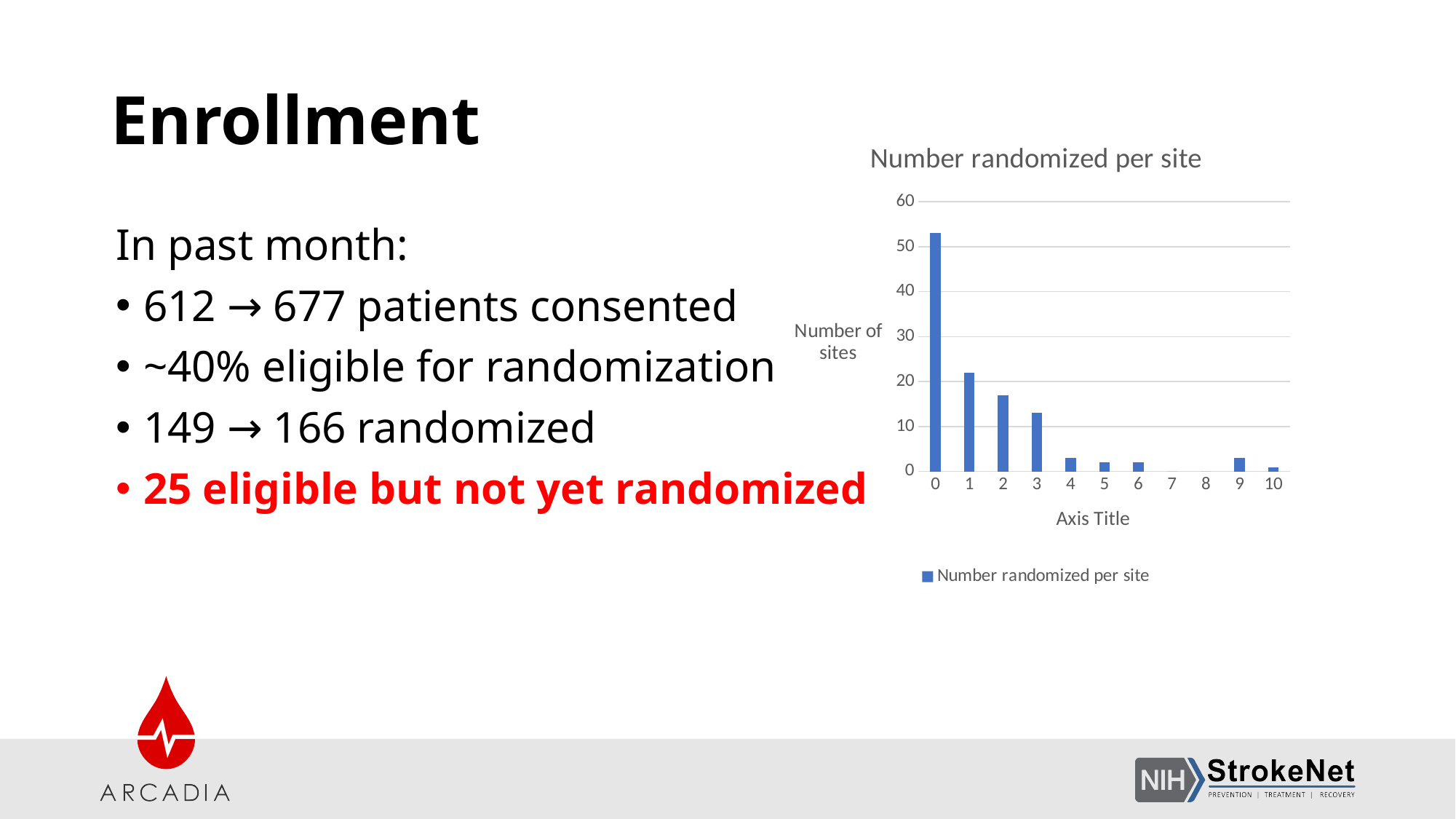
Is the number of sites for category 0 greater or less than 40? greater Is the number of sites for category 2 greater or less than 10? greater How many series does the legend list? 1 Which category has the highest number of sites? 0 What is the label on the vertical axis of the chart? Number of sites What is the title of the chart? Number randomized per site Do the bar heights generally rise or fall as the x axis goes from 0 to 10? fall What kind of chart is shown on the slide? bar chart Is the number of sites for category 1 greater or less than 30? less How many categories are shown on the x axis of the chart? 11 Which has more sites, category 1 or category 2? 1